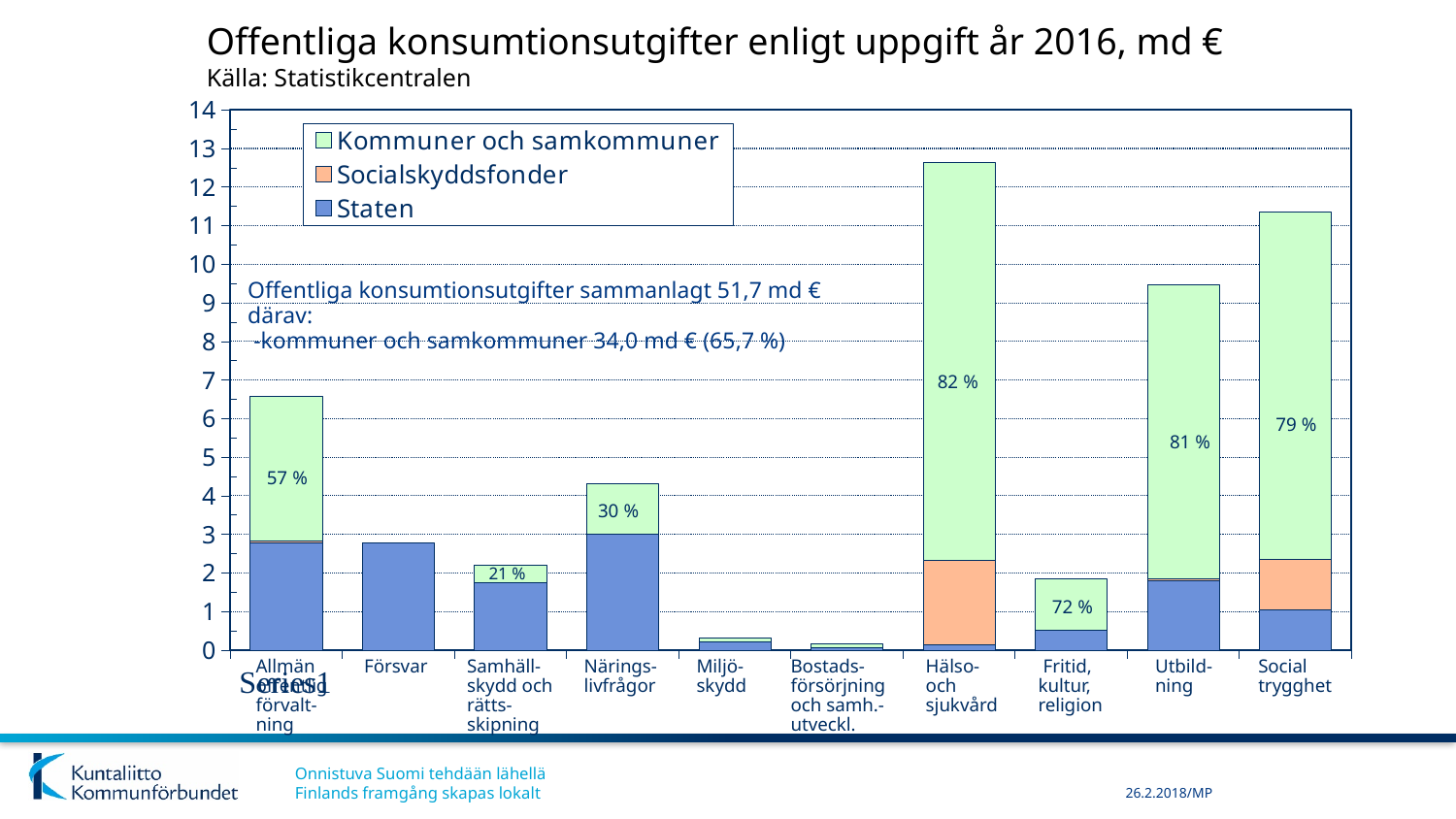
What percentage label is shown on the Samhällskydd och rättsskipning bar? 21 % What kind of chart is shown on the slide? Stacked bar chart Which has the larger total bar, Utbildning or Social trygghet? Social trygghet Which series is shown in blue in the legend? Staten What percentage label is shown on the Utbildning bar? 81 % Is the total value for Försvar greater or less than 3? less According to the text on the chart, what is the total of public consumption expenditure (Offentliga konsumtionsutgifter sammanlagt)? 51,7 md € What percentage label is shown on the Hälso- och sjukvård bar? 82 % How many series does the legend list? 3 Is the total value for Hälso- och sjukvård greater or less than 12? greater Which category has the highest total bar? Hälso- och sjukvård How many categories are shown along the x axis? 10